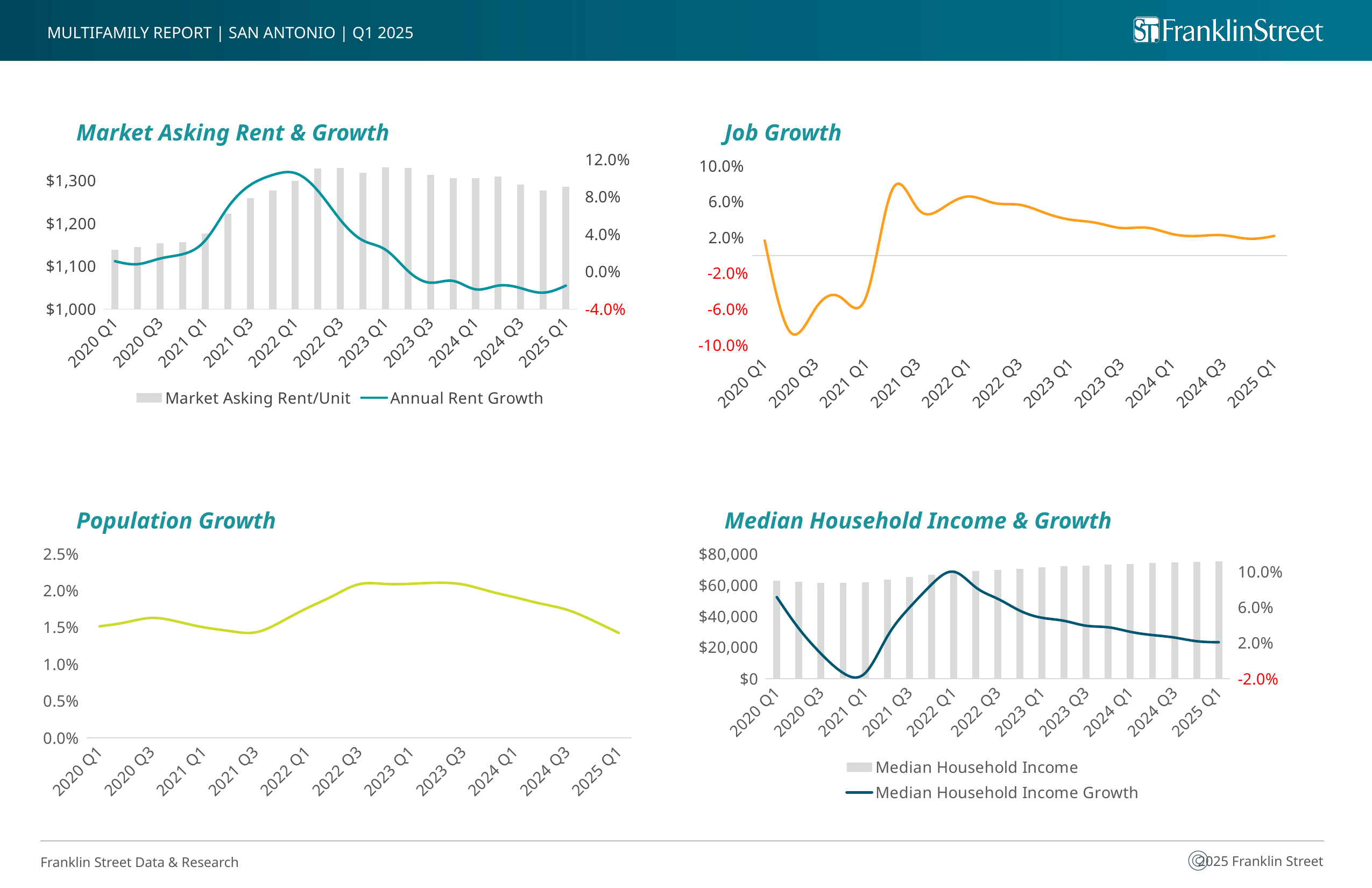
In the Median Household Income & Growth chart, is the Median Household Income for 2025 Q1 greater or less than $60,000? greater In the Market Asking Rent & Growth chart, is the Annual Rent Growth for 2022 Q1 greater or less than 8.0%? greater In the Market Asking Rent & Growth chart, is the Annual Rent Growth for 2025 Q1 greater or less than 4.0%? less What kind of chart is the Job Growth chart? line chart How many series does the legend of the Market Asking Rent & Growth chart list? 2 In the Population Growth chart, do the values rise or fall from 2023 Q3 to 2025 Q1? fall What colour is the line in the Job Growth chart? orange